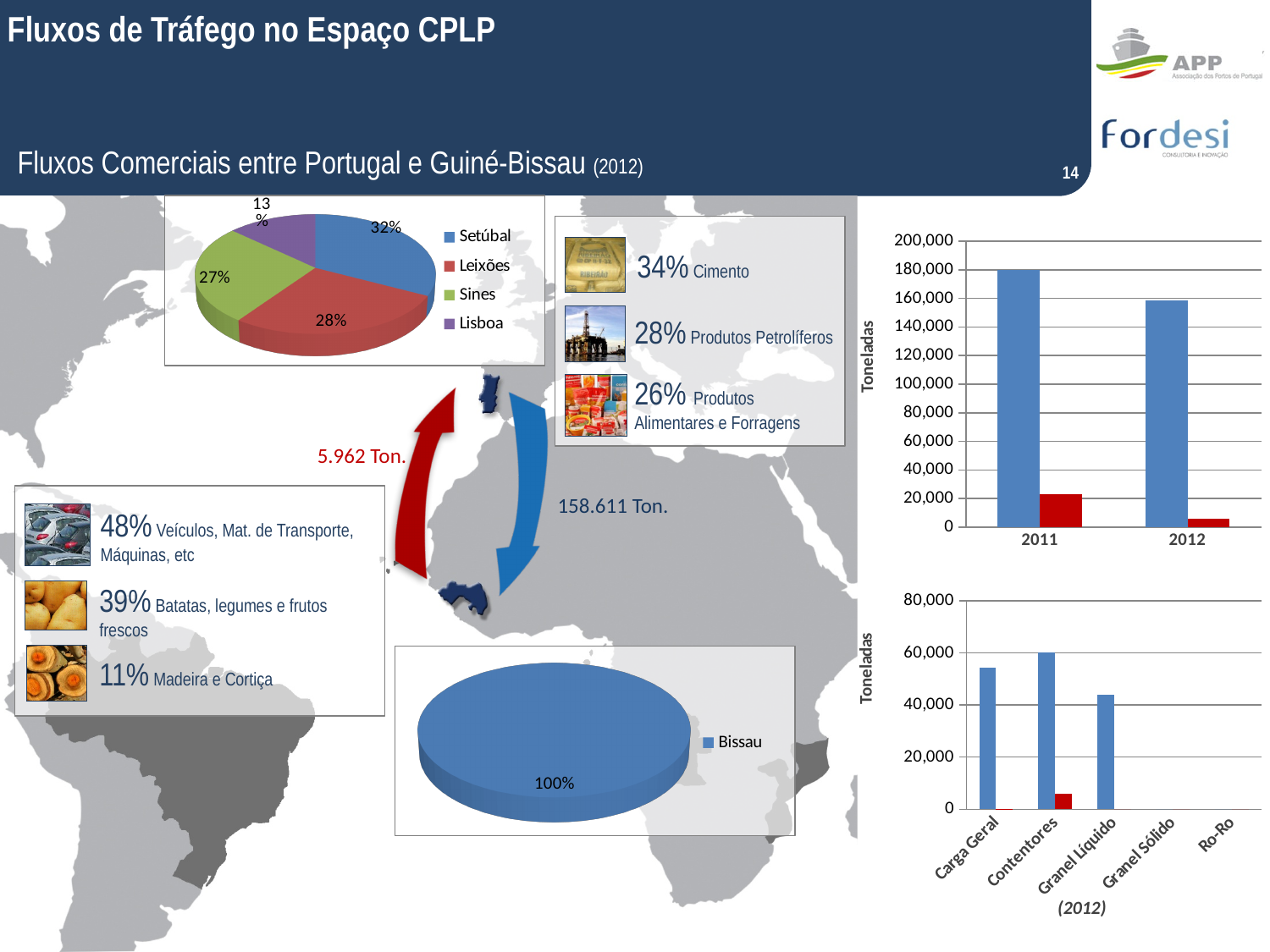
In the top-left pie chart, which port has the smallest share? Lisboa How many categories are shown on the x axis of the bottom-right bar chart? 5 In the top-right bar chart, is the blue bar for 2011 greater or less than 160,000? greater In the bottom-center pie chart, what share does Bissau have? 100% What kind of chart is the top-right chart with the years 2011 and 2012? bar chart In the top-left pie chart, what share does Sines have? 27% In the top-left pie chart, which port has the largest share? Setúbal In the top-right bar chart, which year has the taller blue bar, 2011 or 2012? 2011 In the top-left pie chart, what is the difference in percentage points between Leixões and Lisboa? 15 In the top-left pie chart, what share does Setúbal have? 32% How many entries does the legend of the top-left pie chart list? 4 In the bottom-right bar chart, which category has the tallest blue bar? Contentores